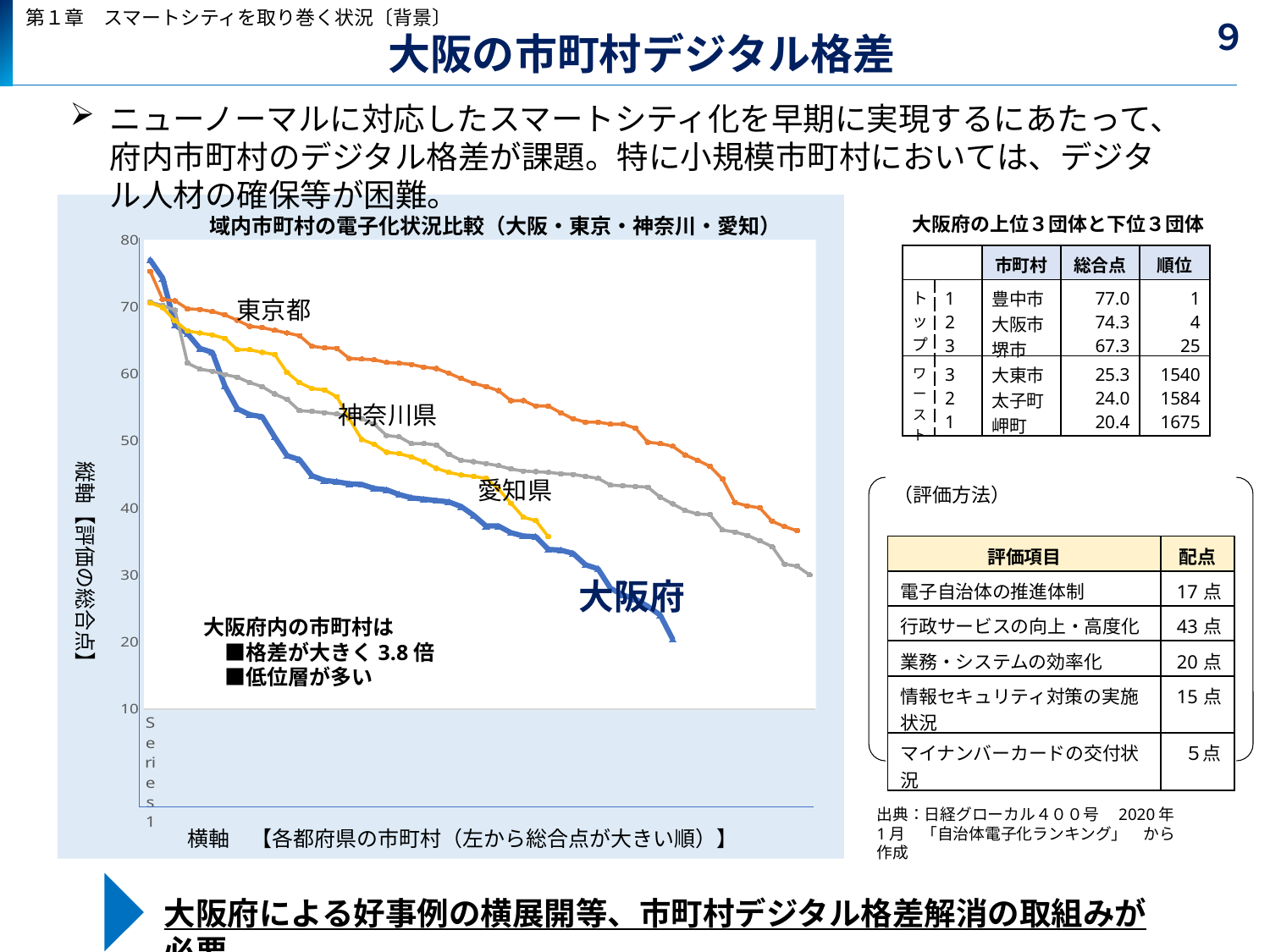
Do the values along each line rise or fall from left to right? fall What is the maximum value shown on the vertical axis of the chart? 80 At the right end of the chart, which line is lower: 大阪府 or 東京都? 大阪府 What is the title of the chart? 域内市町村の電子化状況比較（大阪・東京・神奈川・愛知） Is the lowest value on the 大阪府 line greater or less than 30? less Is the first (leftmost) value on the 大阪府 line greater or less than 70? greater Is the last (rightmost) value on the 東京都 line greater or less than 30? greater Which prefecture's line is the lowest on the chart? 大阪府 How many prefectures' lines are plotted on the chart? 4 What kind of chart is shown on the slide? line chart Which prefecture's line is the highest across most of the chart? 東京都